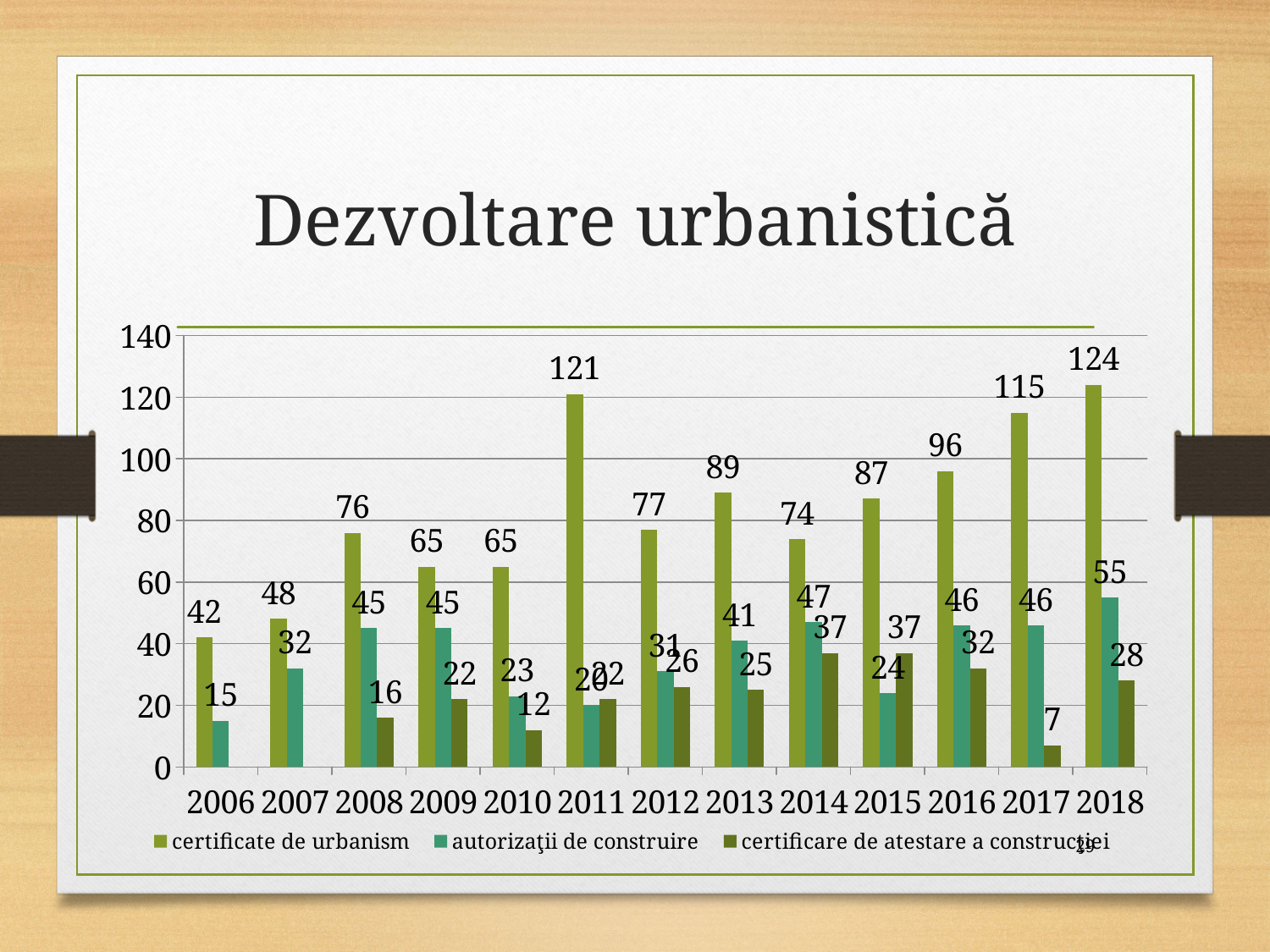
How many years are shown on the x axis? 13 What is the value of autorizaţii de construire for 2013? 41 What kind of chart is shown on the slide? bar chart In which year is autorizaţii de construire lowest? 2006 In which year is certificate de urbanism highest? 2018 What is the value of certificare de atestare a construcţiei for 2017? 7 Do the values for certificate de urbanism rise or fall from 2015 to 2018? rise What is the title of the slide? Dezvoltare urbanistică What is the value of certificate de urbanism for 2011? 121 In 2014, which is larger: autorizaţii de construire or certificare de atestare a construcţiei? autorizaţii de construire How many series does the legend list? 3 What is the difference between certificate de urbanism and autorizaţii de construire in 2018? 69